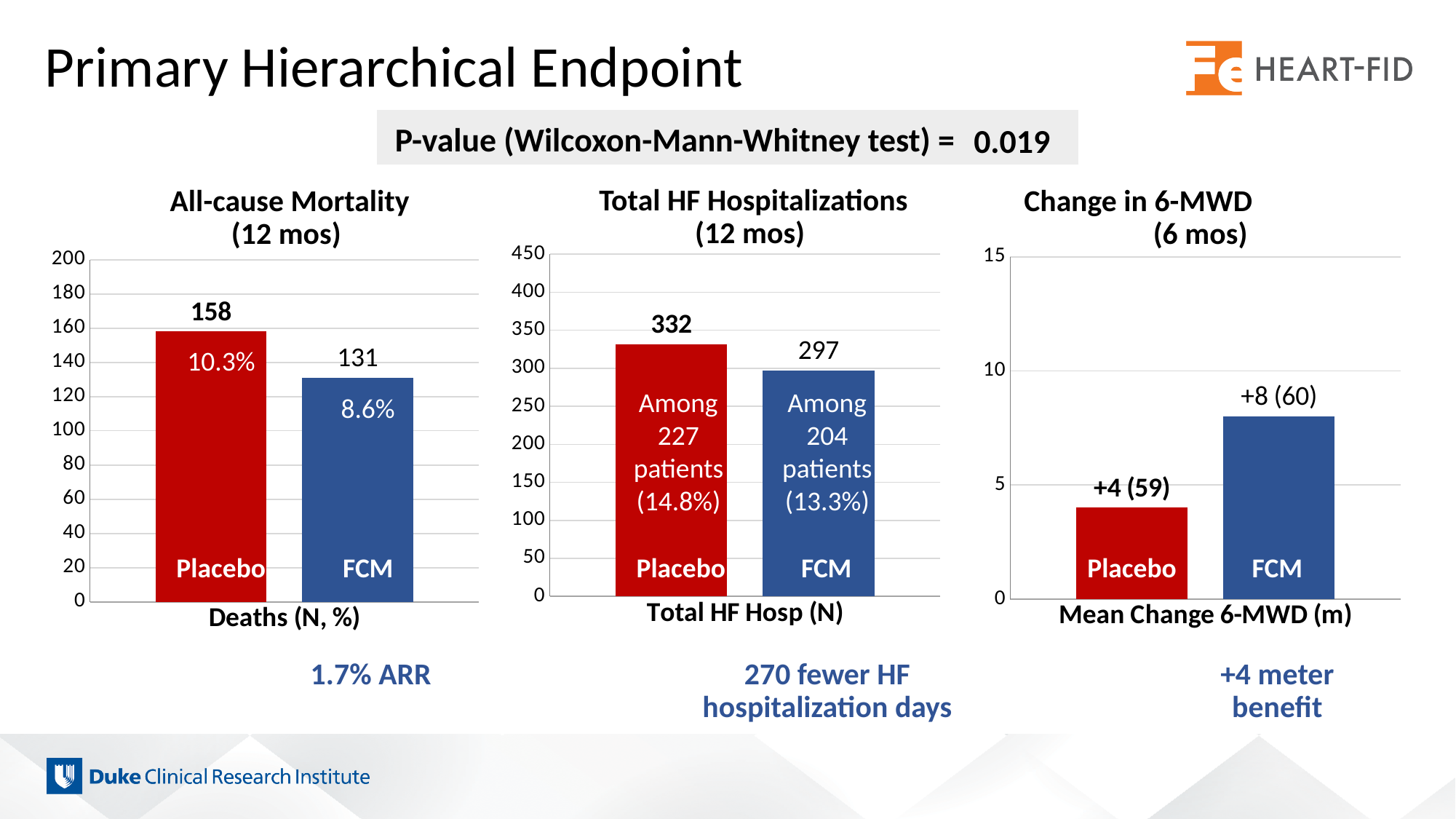
What type of chart is the All-cause Mortality (12 mos) chart? Bar chart In the Change in 6-MWD (6 mos) chart, is the value for FCM greater or less than 5? greater In the Total HF Hospitalizations (12 mos) chart, what is the value for FCM? 297 In the Total HF Hospitalizations (12 mos) chart, which group has the higher number of hospitalizations? Placebo In the Total HF Hospitalizations (12 mos) chart, among how many patients did the Placebo hospitalizations occur? 227 In the All-cause Mortality (12 mos) chart, what percentage is printed on the FCM bar? 8.6% In the Change in 6-MWD (6 mos) chart, what is the label on the FCM bar? +8 (60) What P-value is shown at the top of the slide for the Wilcoxon-Mann-Whitney test? 0.019 In the Change in 6-MWD (6 mos) chart, which group has the lower mean change? Placebo In the Total HF Hospitalizations (12 mos) chart, what is the difference between the Placebo and FCM values? 35 In the All-cause Mortality (12 mos) chart, how many deaths are shown for Placebo? 158 In the All-cause Mortality (12 mos) chart, what is the difference in deaths between Placebo and FCM? 27